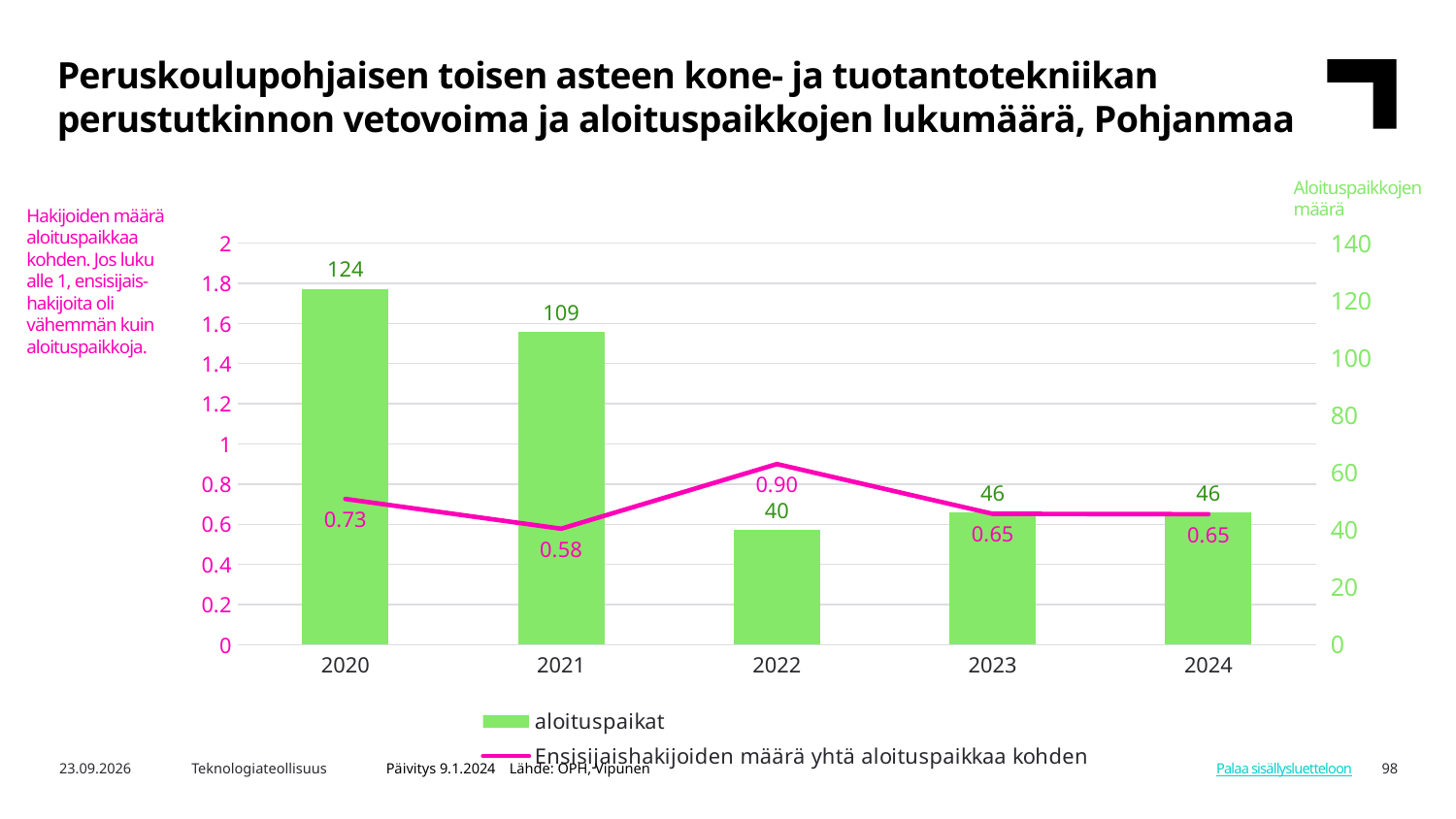
Which is larger, the aloituspaikat value for 2021 or for 2023? 2021 Which year has the lowest value of aloituspaikat? 2022 What is the value of aloituspaikat for 2020? 124 Which year has the highest value of aloituspaikat? 2020 How many years are shown on the x axis? 5 What is the difference in aloituspaikat between 2020 and 2021? 15 What colour are the aloituspaikat bars? Green What is the value of aloituspaikat for 2022? 40 How many series does the legend list? 2 Which year has the lowest value of Ensisijaishakijoiden määrä yhtä aloituspaikkaa kohden? 2021 Is the aloituspaikat value for 2023 greater or less than 60? less What is the value of Ensisijaishakijoiden määrä yhtä aloituspaikkaa kohden for 2022? 0.90